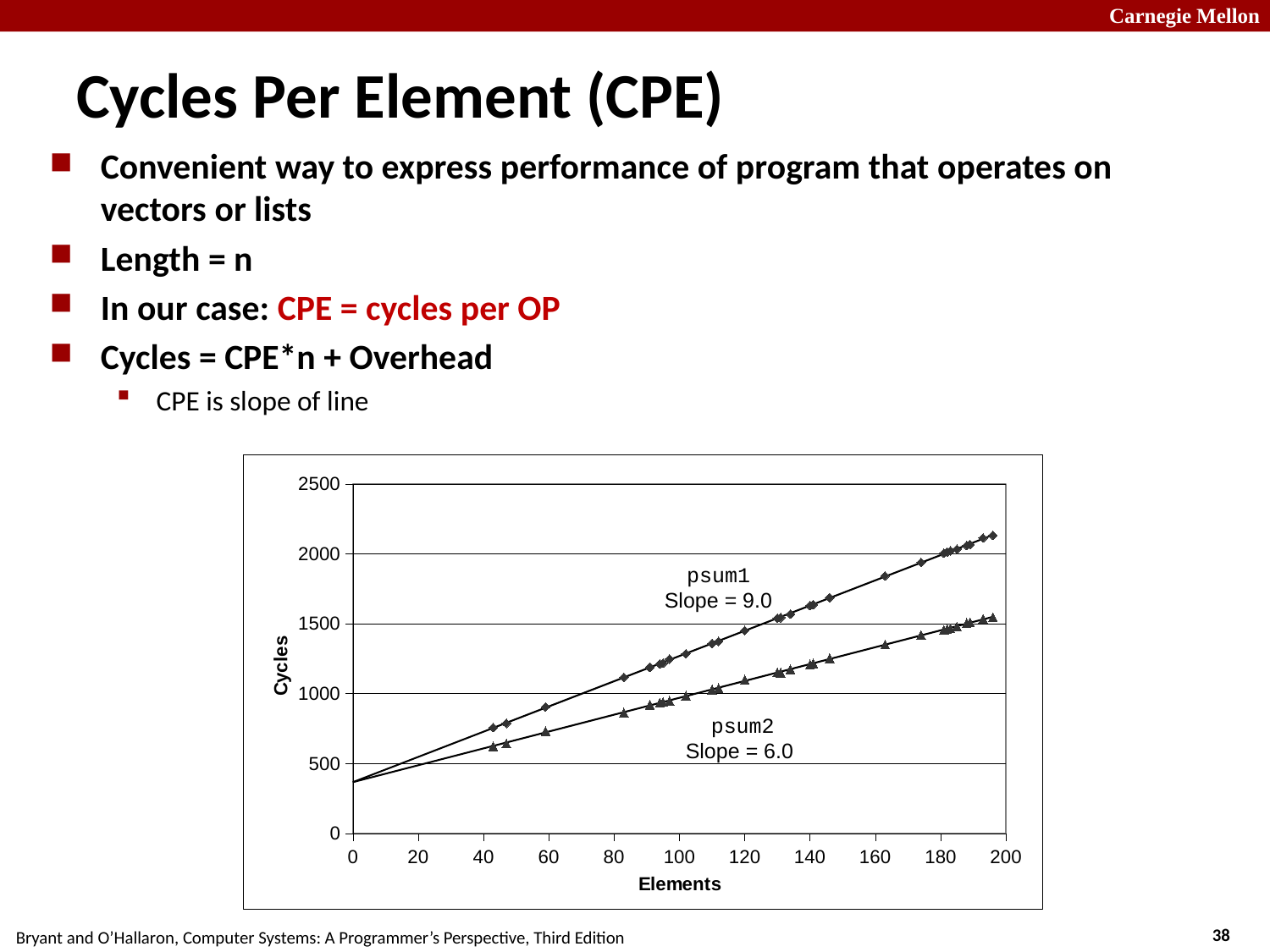
Do the cycle counts rise or fall as the number of elements increases? rise Which series has the larger slope, psum1 or psum2? psum1 What kind of chart is shown on the slide? scatter plot with fitted lines What is the slope of the psum2 line? 6.0 What is the difference between the slopes of psum1 and psum2? 3.0 Is the value for psum2 at about 100 elements greater or less than 1500 cycles? less What is the label of the x axis? Elements What is the label of the y axis? Cycles Is the value for psum1 at about 100 elements greater or less than 1000 cycles? greater What is the slope of the psum1 line? 9.0 How many data series are plotted on the chart? 2 Is the value for psum1 at about 195 elements greater or less than 2000 cycles? greater